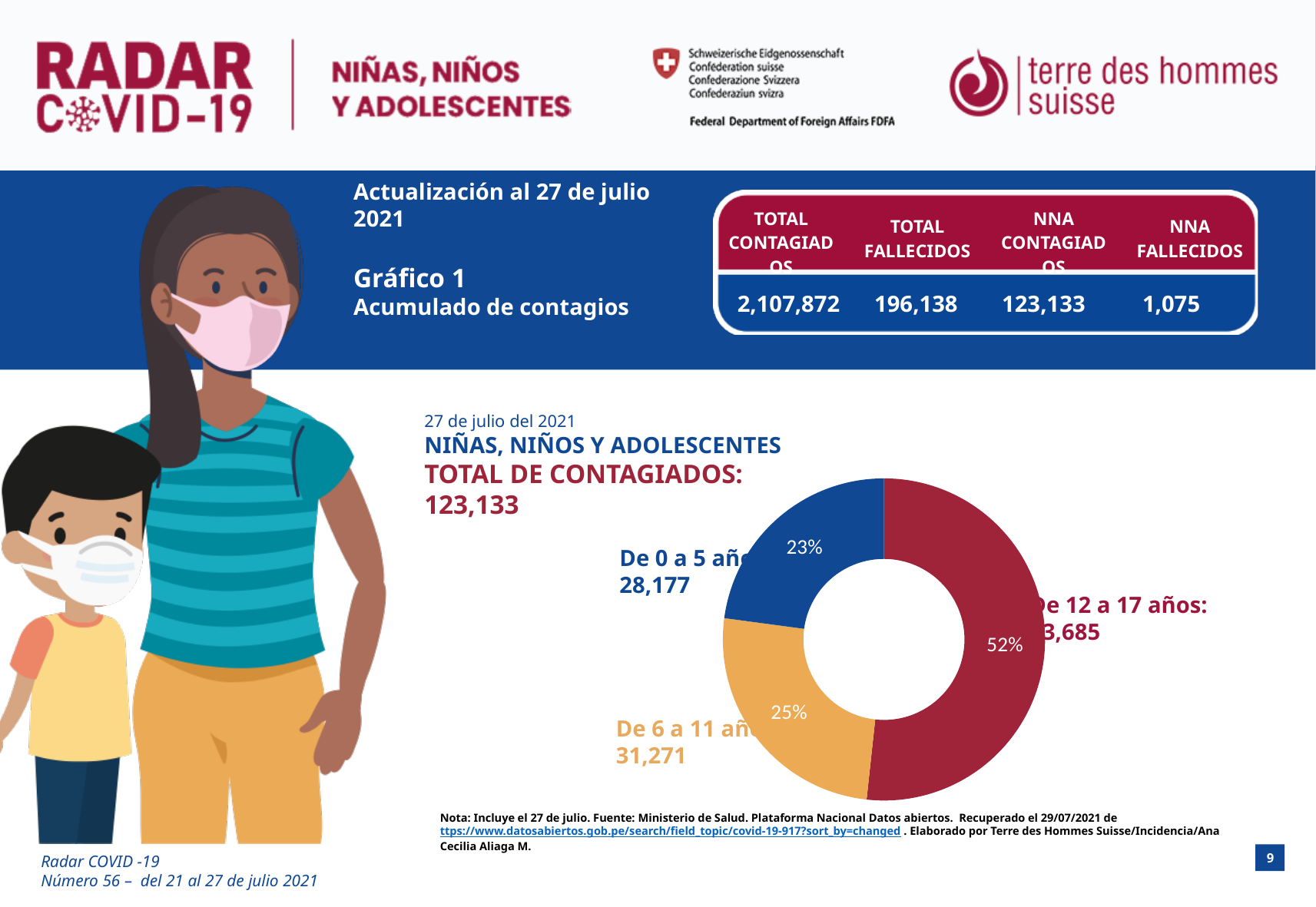
How many age-group categories does the chart show? 3 What share of the chart does the 'De 0 a 5 años' slice represent? 23% What share of the chart does the 'De 12 a 17 años' slice represent? 52% What kind of chart is shown on the slide? pie chart (donut) Which has more contagiados, 'De 0 a 5 años' or 'De 6 a 11 años'? De 6 a 11 años Which age group has the largest slice of the chart? De 12 a 17 años What is the number of contagiados for 'De 0 a 5 años'? 28,177 What total de contagiados is stated above the chart? 123,133 What is the difference in contagiados between 'De 6 a 11 años' and 'De 0 a 5 años'? 3,094 What is the number of contagiados for 'De 6 a 11 años'? 31,271 What share of the chart does the 'De 6 a 11 años' slice represent? 25% Which age group has the smallest slice of the chart? De 0 a 5 años